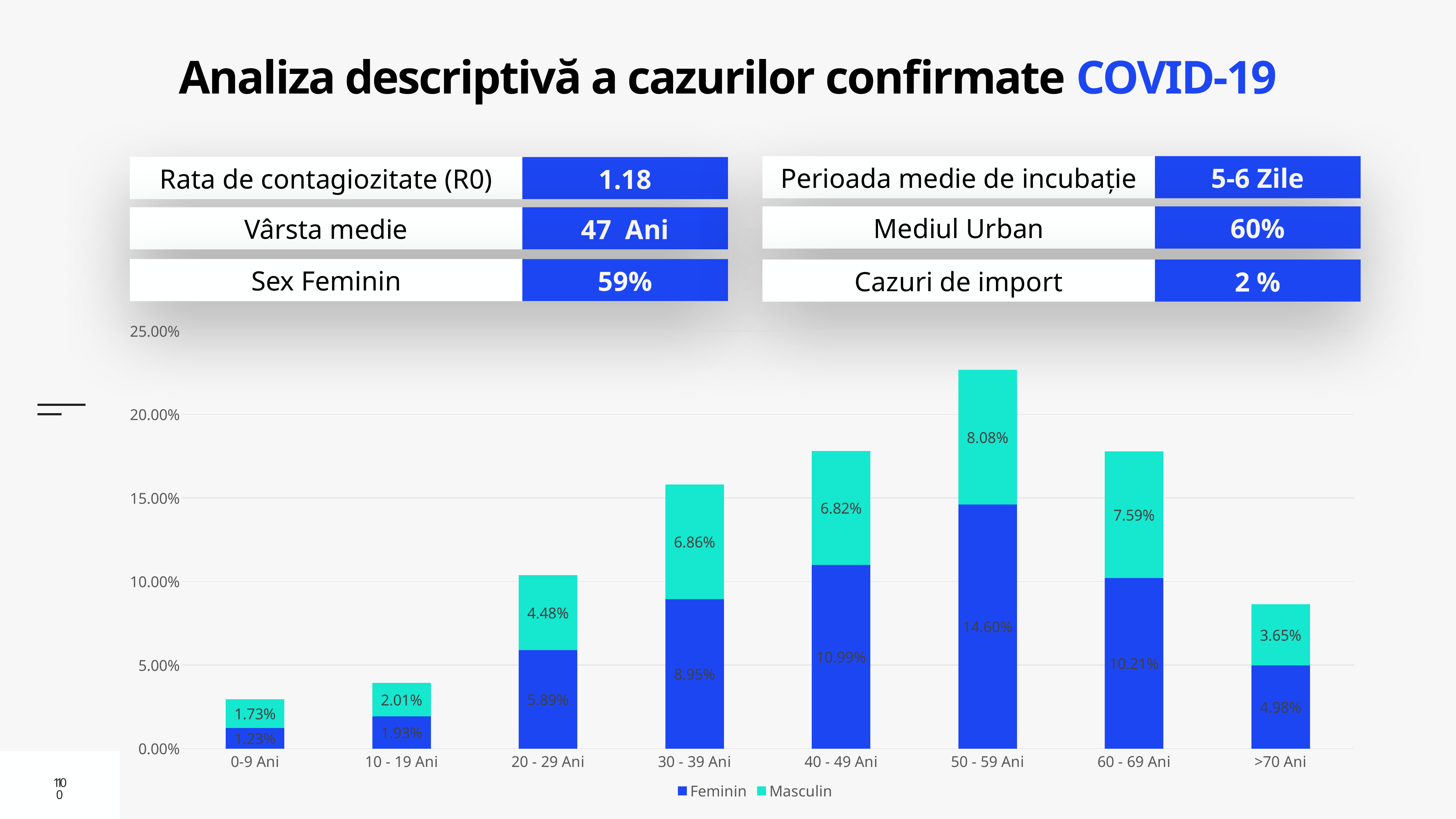
Which series is shown in dark blue in the chart? Feminin What is the difference between the Feminin and Masculin values for the 40 - 49 Ani age group? 4.17% How many age groups are shown on the x axis of the chart? 8 What is the total of the stacked bar for the 50 - 59 Ani age group? 22.68% What is the Feminin value for the >70 Ani age group? 4.98% What is the Masculin value for the 20 - 29 Ani age group? 4.48% What is the Feminin value for the 50 - 59 Ani age group? 14.60% Which age group has the highest Feminin value? 50 - 59 Ani How many series does the chart legend list? 2 Which is larger for the 0-9 Ani age group, the Feminin value or the Masculin value? Masculin Which age group has the lowest Masculin value? 0-9 Ani What kind of chart is shown on the slide? Stacked bar chart